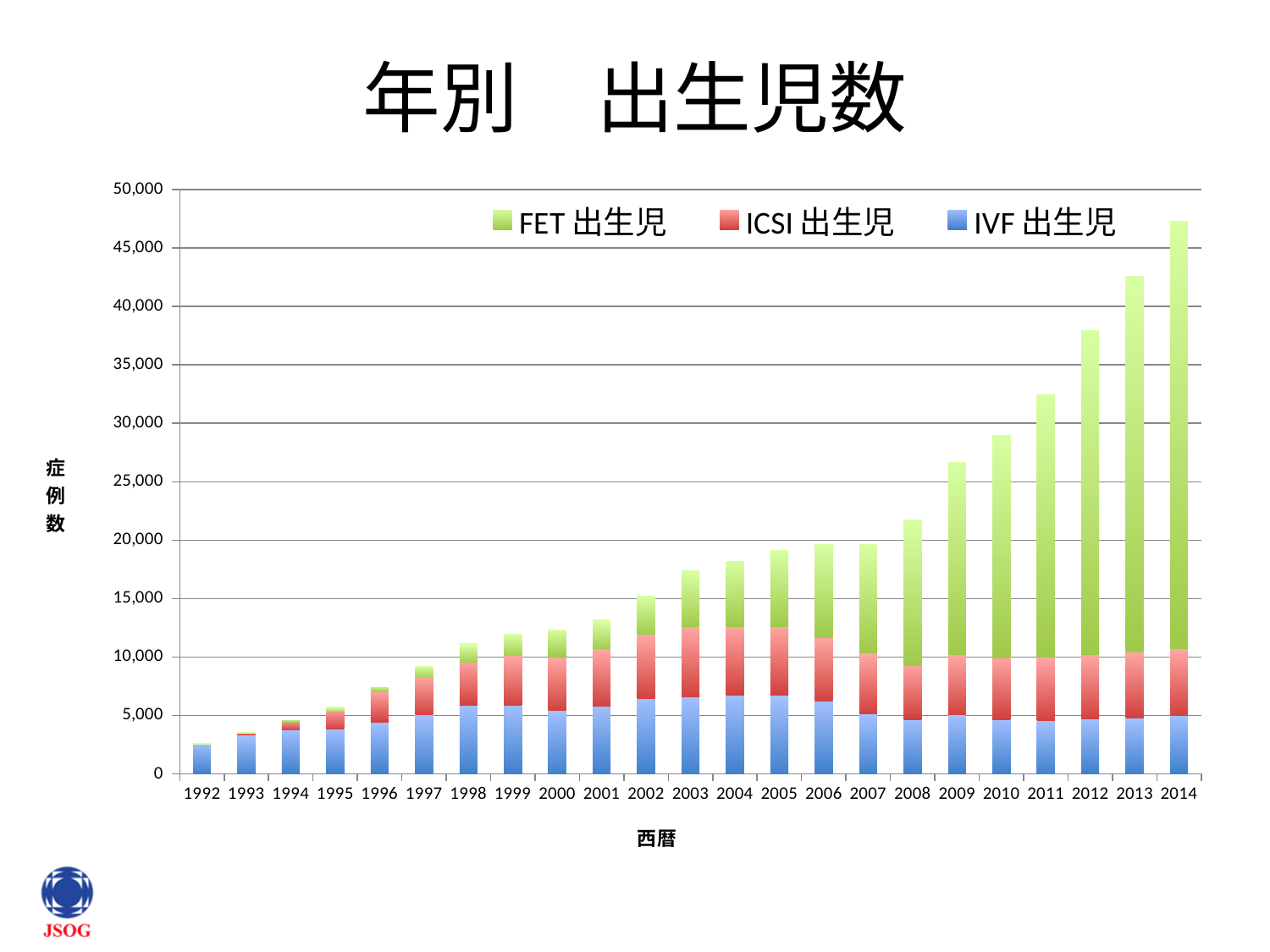
Which year has the lowest total number of births? 1992 Which year has the highest total number of births? 2014 Is the total value for 1992 greater or less than 5,000? less Is the total value for 2013 greater or less than 40,000? greater What kind of chart is shown on the slide? Stacked bar chart Is the total value for 2012 greater or less than 40,000? less How many years are shown along the x axis? 23 Do the total births rise or fall from 1992 to 2014? rise Which series is shown in green in the legend? FET 出生児 How many series does the legend list? 3 What is the title of the chart? 年別 出生児数